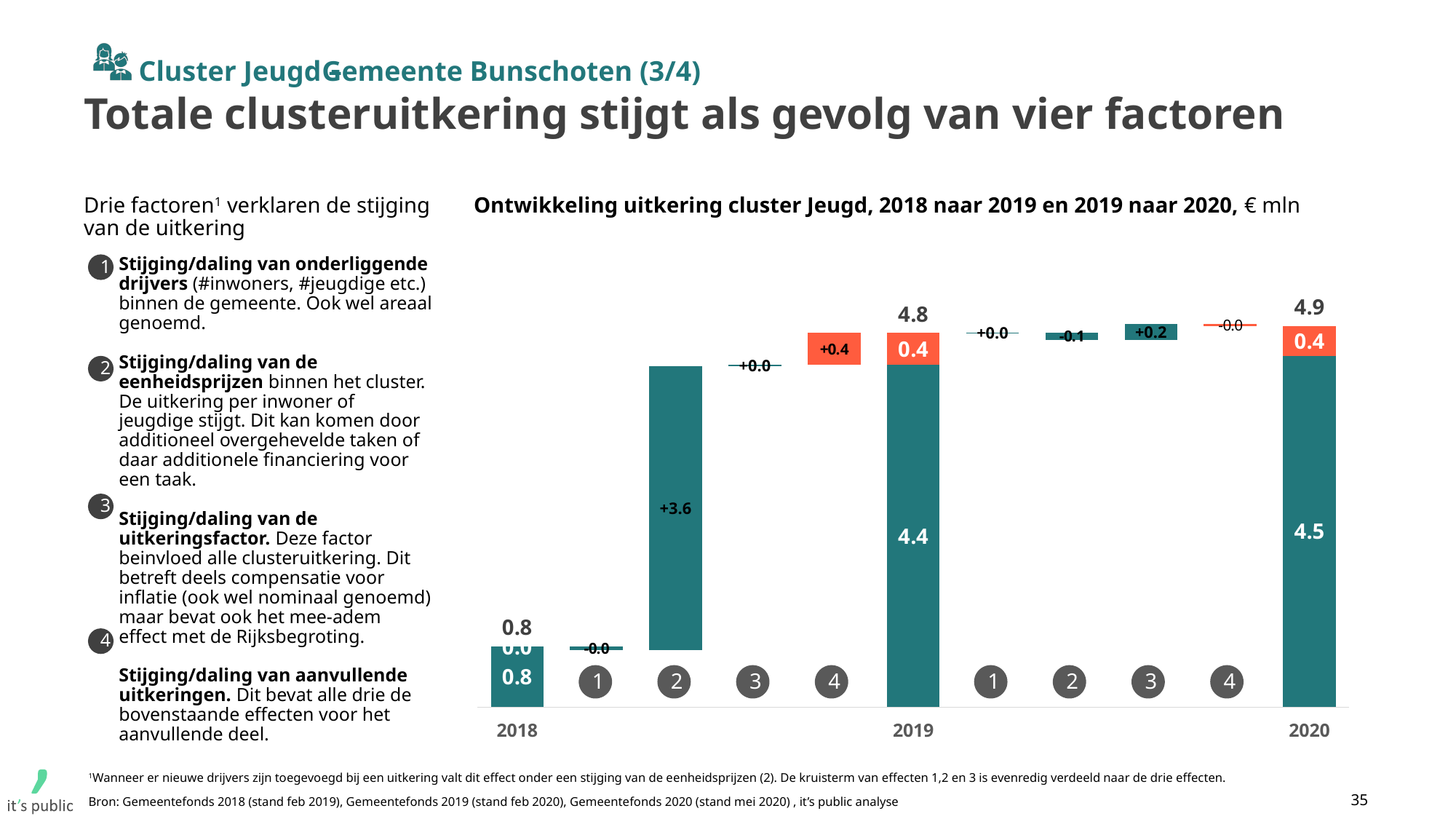
What is the total uitkering for 2020 shown in the chart? 4.9 What is the total uitkering for 2018 shown in the chart? 0.8 What is the value of the factor 4 step between 2018 and 2019? +0.4 What is the value of the factor 3 step between 2019 and 2020? +0.2 What is the total uitkering for 2019 shown in the chart? 4.8 What is the value of the teal (lower) segment of the 2020 bar? 4.5 By how much does the total uitkering increase from 2019 to 2020? 0.1 In what unit are the values in the chart expressed? € mln What is the value of the factor 2 step between 2018 and 2019? +3.6 By how much does the total uitkering increase from 2018 to 2019? 4.0 What is the value of the factor 2 step between 2019 and 2020? -0.1 Which of the four factors contributes the largest step between 2018 and 2019? Factor 2